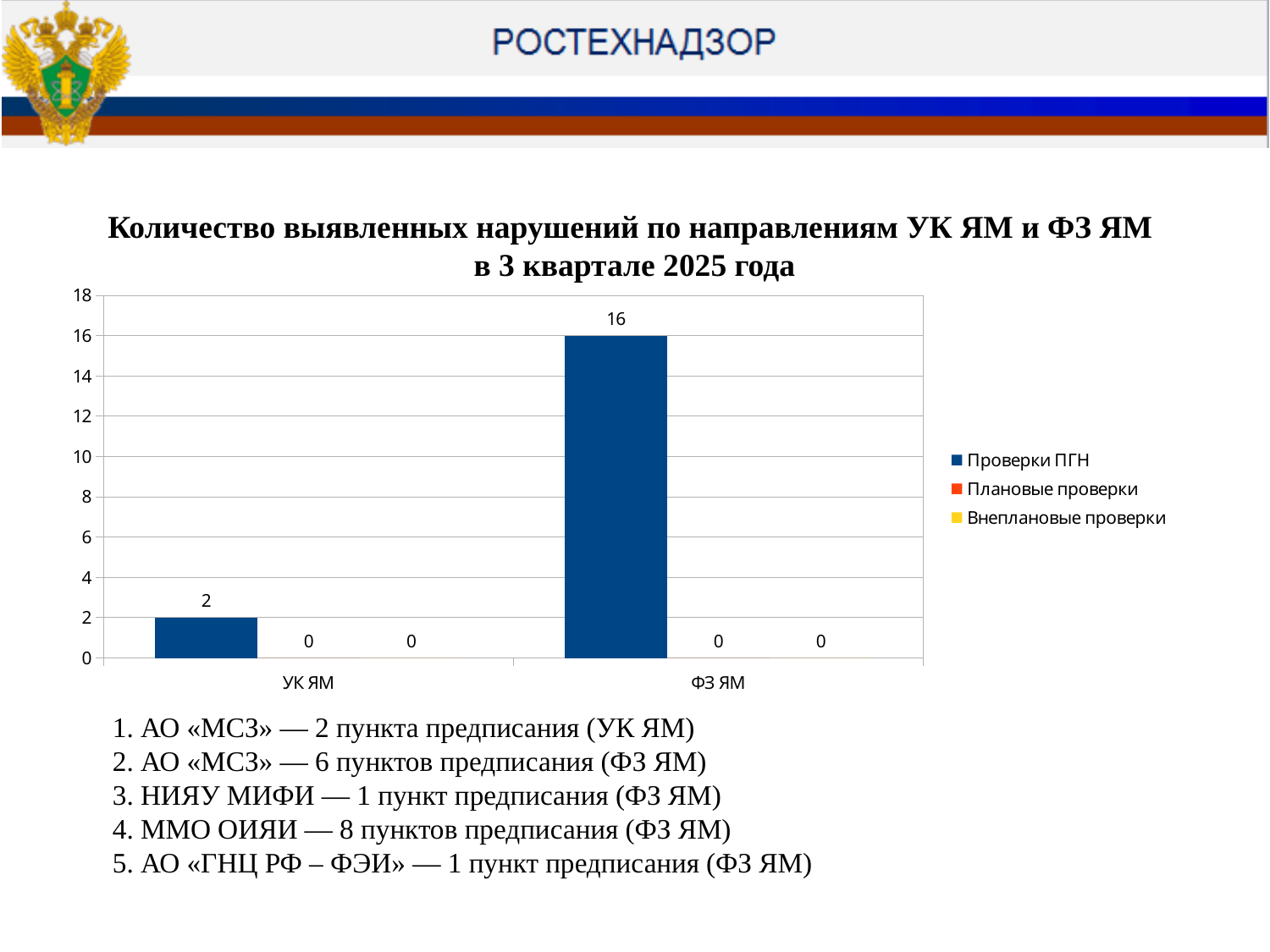
Is the Проверки ПГН value for УК ЯМ larger or smaller than the Проверки ПГН value for ФЗ ЯМ? smaller How many series does the legend list? 3 What is the value for Внеплановые проверки in the УК ЯМ category? 0 What is the difference between the Проверки ПГН values for ФЗ ЯМ and УК ЯМ? 14 Which category has the higher value for Проверки ПГН? ФЗ ЯМ What kind of chart is shown on the slide? bar chart Which series is shown in dark blue in the legend? Проверки ПГН What is the value for Проверки ПГН in the УК ЯМ category? 2 What is the value for Проверки ПГН in the ФЗ ЯМ category? 16 How many categories are shown on the x axis? 2 Is the value for Проверки ПГН in ФЗ ЯМ greater or less than 10? greater What is the value for Плановые проверки in the ФЗ ЯМ category? 0